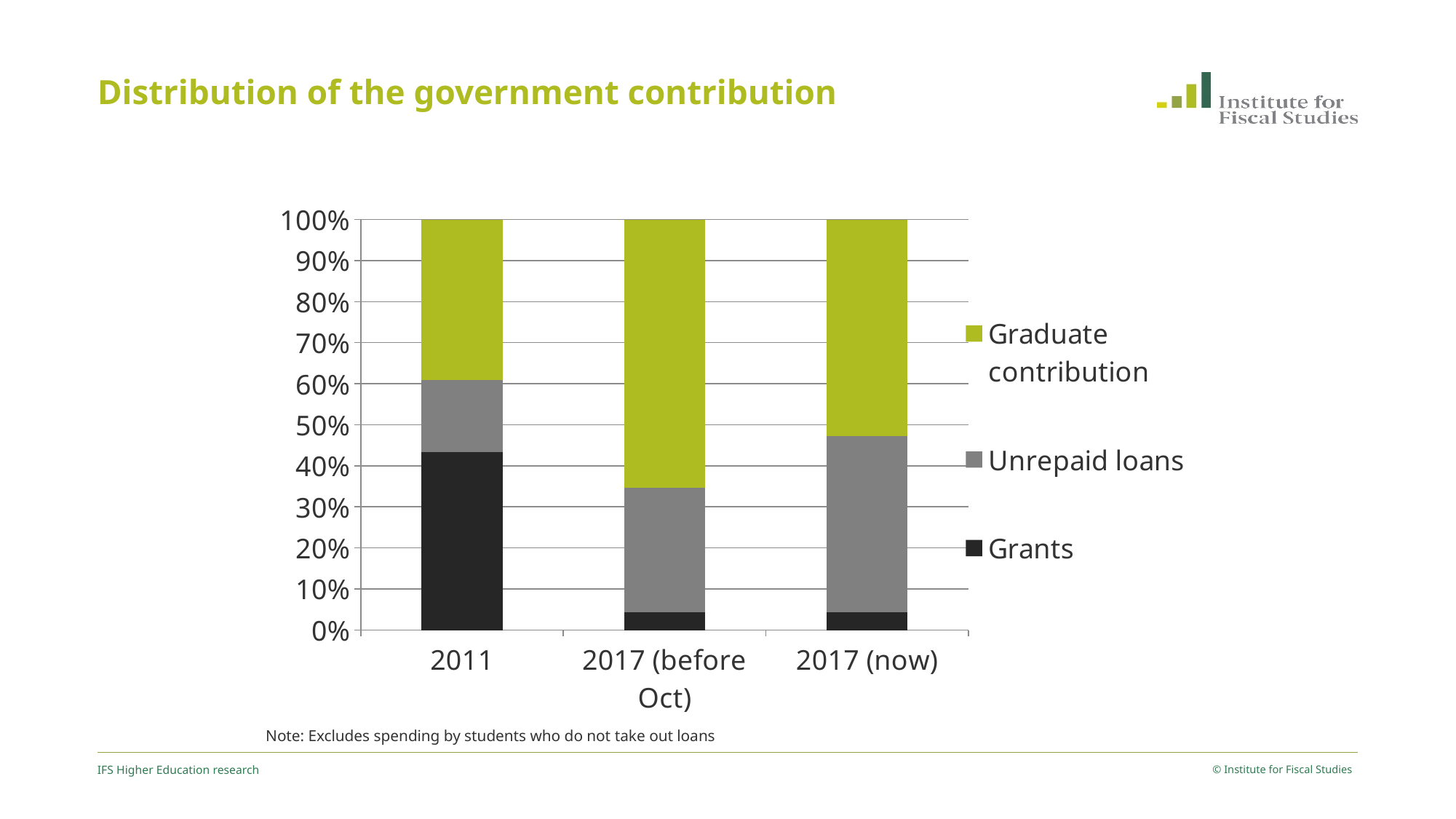
Which category has the largest Graduate contribution share? 2017 (before Oct) Which category has the largest Grants share? 2011 Which is larger, the Unrepaid loans share for 2011 or for 2017 (now)? 2017 (now) Is the Unrepaid loans share for 2017 (now) greater or less than 30%? greater How many series does the legend list? 3 How many categories are shown on the x axis? 3 Is the Grants share for 2017 (now) greater or less than 10%? less What is the title of the chart? Distribution of the government contribution Is the Graduate contribution share for 2017 (before Oct) greater or less than 60%? greater Which series is shown in dark grey/black at the bottom of each bar? Grants What kind of chart is shown on the slide? Stacked bar chart